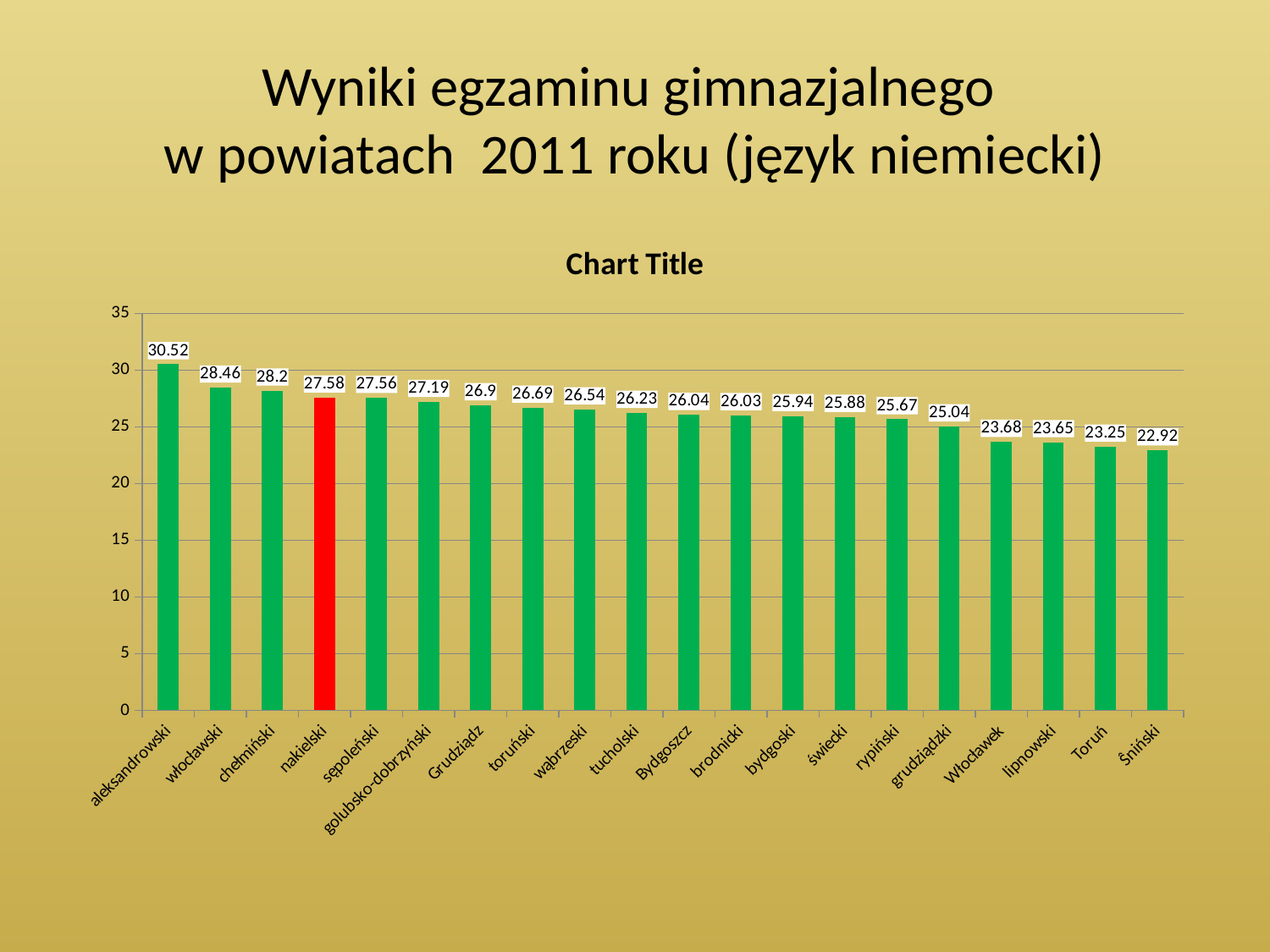
What is the value for Grudziądz? 26.9 What is the difference between the values for aleksandrowski and żniński? 7.6 What is the value for Toruń? 23.25 Which is larger, the value for włocławski or the value for Włocławek? włocławski Which category has the highest value? aleksandrowski Is the value for lipnowski greater or less than 25? less Which category's bar is coloured red instead of green? nakielski What is the value for aleksandrowski? 30.52 What kind of chart is shown on the slide? bar chart What is the value for nakielski? 27.58 Which category has the lowest value? Ŝniński How many categories are shown on the x axis? 20